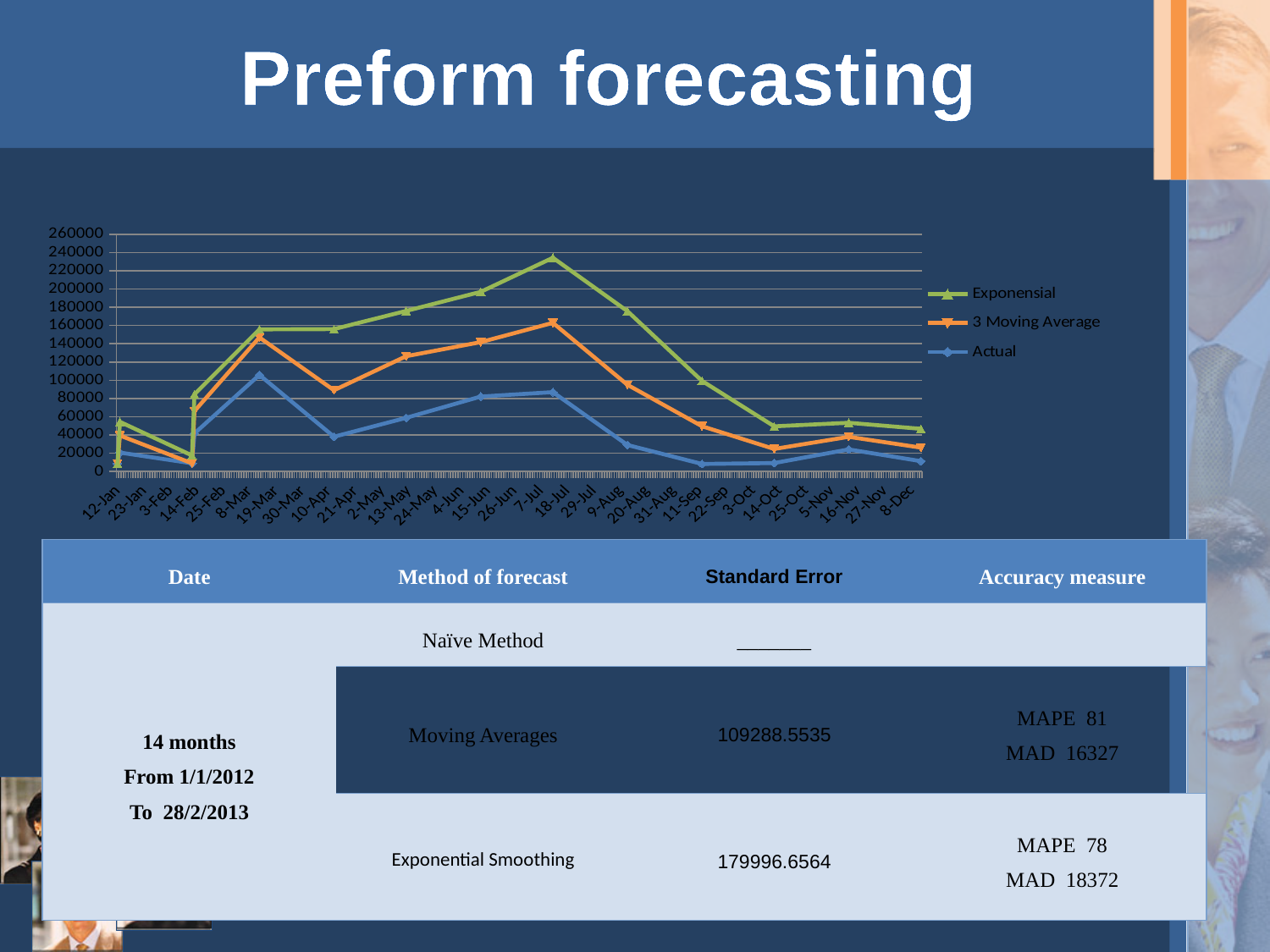
What are the three series named in the chart's legend? Exponensial, 3 Moving Average, Actual Is the peak value of the Exponensial series greater or less than 200000? greater Around 8-Mar, which series has the larger value: 3 Moving Average or Actual? 3 Moving Average Which series reaches the highest value anywhere on the chart? Exponensial Is the peak value of the Actual series greater or less than 80000? greater How many series does the chart's legend list? 3 Is the value of the 3 Moving Average series at 18-Jul greater or less than 140000? greater Around 18-Jul, which series has the larger value: Exponensial or Actual? Exponensial Does the Exponensial series rise or fall between 18-Jul and 8-Dec? fall What is the highest tick value shown on the chart's vertical axis? 260000 What kind of chart is shown on the slide? line chart